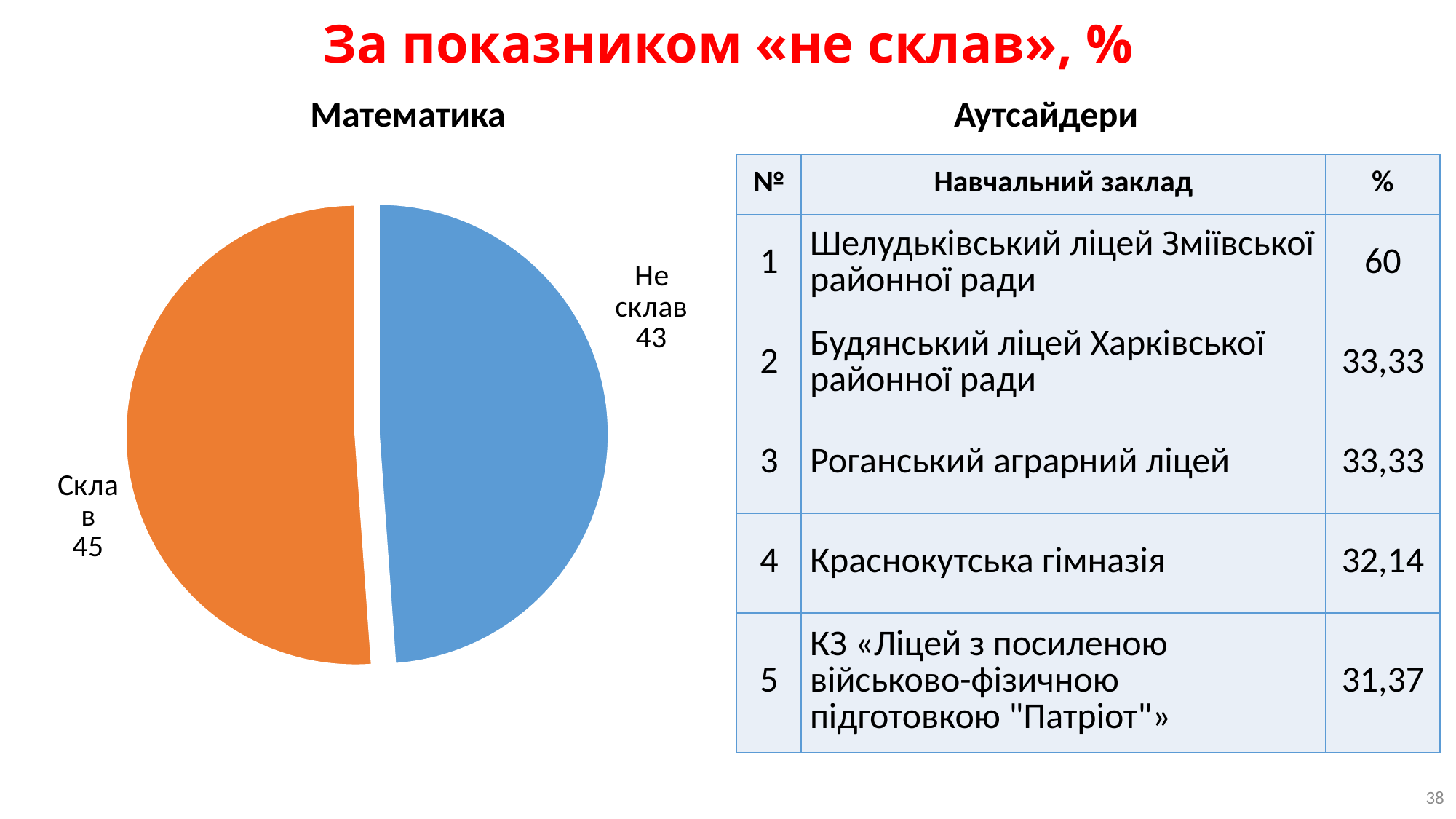
What colour is the «Склав» slice in the «Математика» pie chart? orange What type of chart is shown under the heading «Математика»? pie chart What is the difference between the «Склав» and «Не склав» values in the «Математика» pie chart? 2 What colour is the «Не склав» slice in the «Математика» pie chart? blue In the «Математика» pie chart, what is the value for «Не склав»? 43 Which slice of the «Математика» pie chart is larger, «Склав» or «Не склав»? Склав What is the total of the two slice values in the «Математика» pie chart? 88 How many slices does the «Математика» pie chart have? 2 Which category has the lowest value in the «Математика» pie chart? Не склав Which category has the highest value in the «Математика» pie chart? Склав In the «Математика» pie chart, what is the value for «Склав»? 45